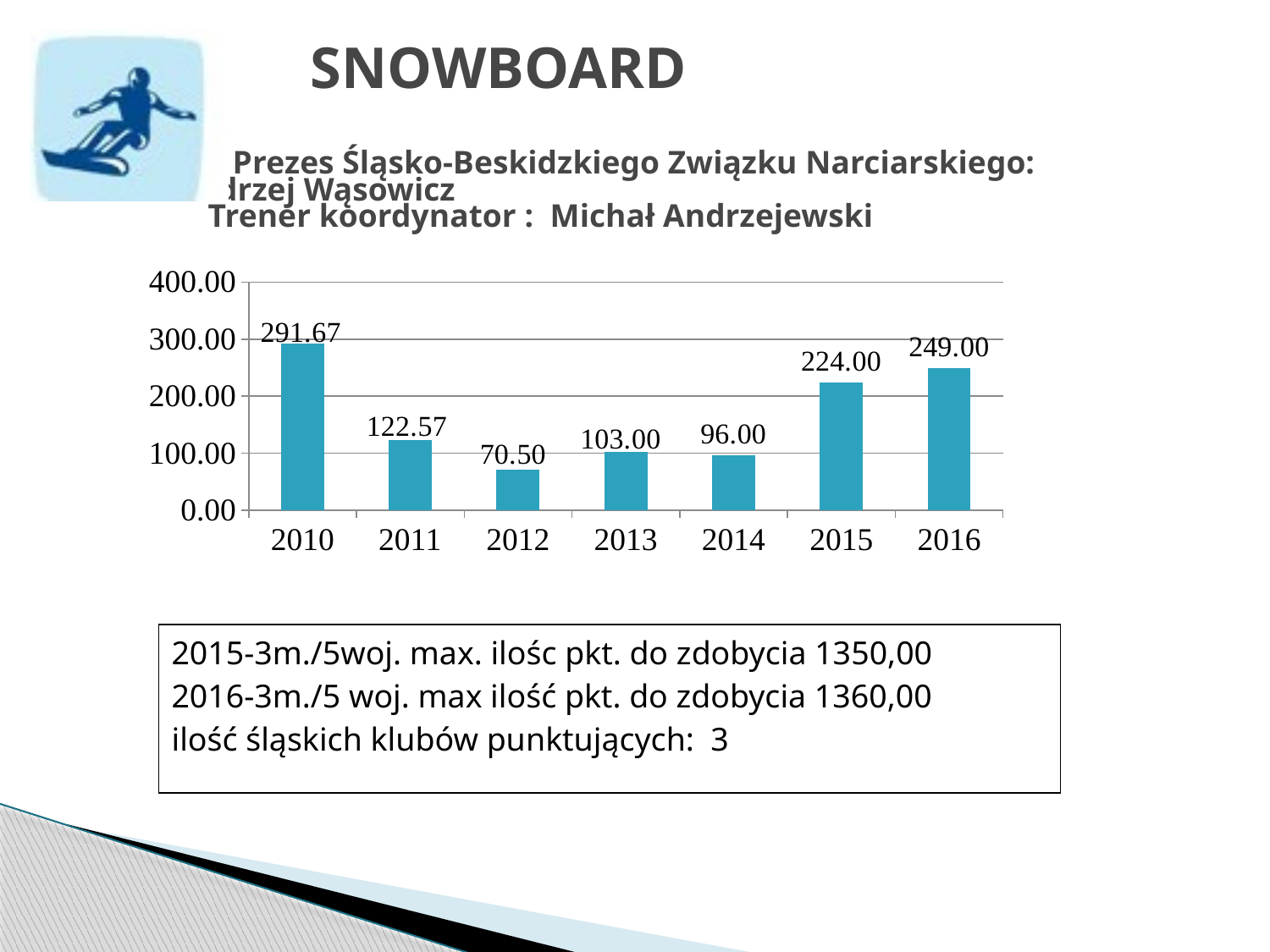
What is the difference between the values for 2016 and 2015? 25.00 Which year has the lowest value? 2012 What kind of chart is shown on the slide? bar chart How many years are shown on the x axis? 7 Do the values rise or fall from 2014 to 2016? rise What is the value for 2010? 291.67 What is the highest value shown on the y axis? 400.00 Which year has the highest value? 2010 What is the value for 2012? 70.50 What is the value for 2016? 249.00 Which is larger, the value for 2013 or the value for 2014? 2013 Is the value for 2011 greater or less than 100.00? greater